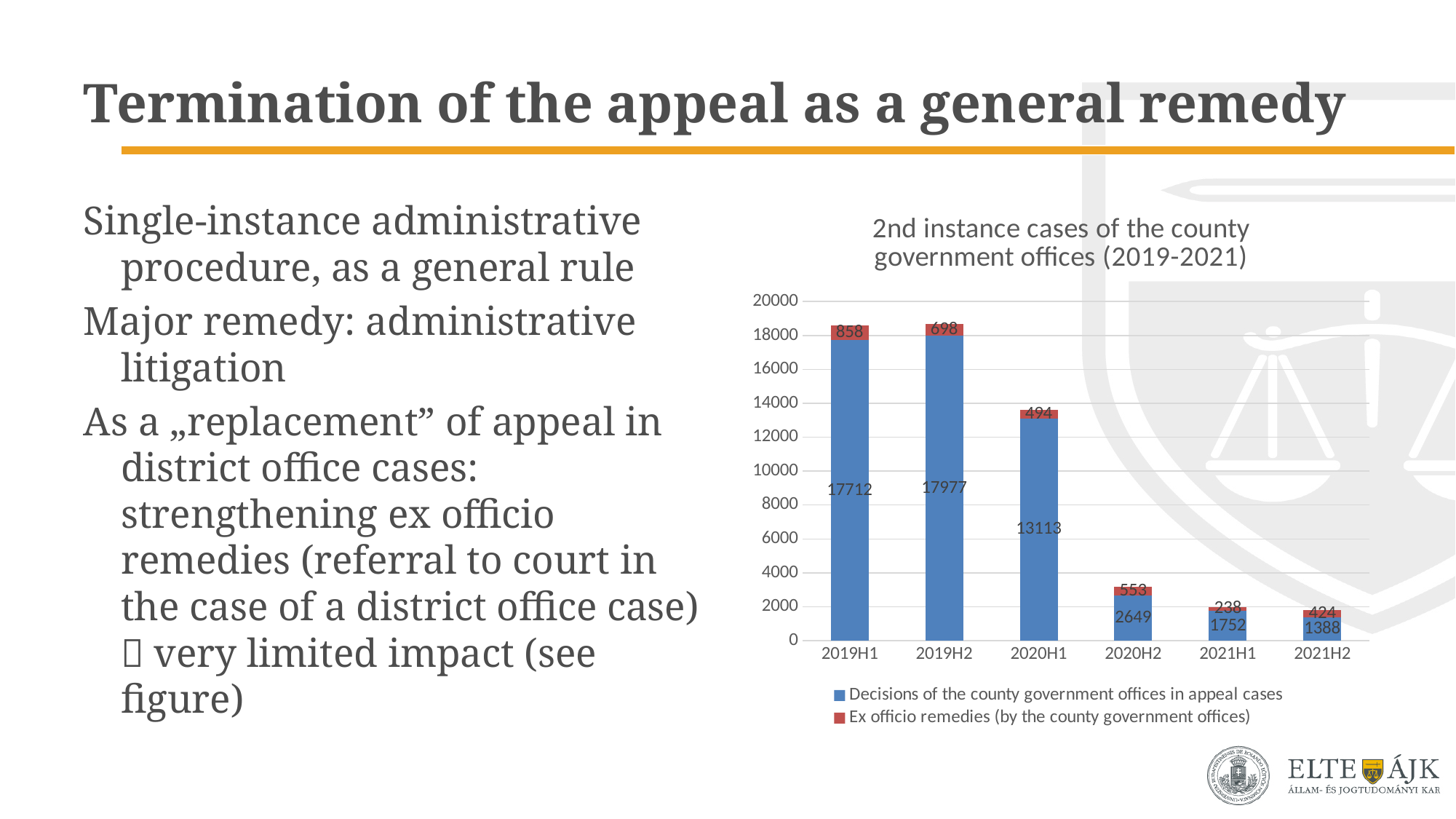
What is the value of Decisions of the county government offices in appeal cases for 2019H2? 17977 What is the title of the chart? 2nd instance cases of the county government offices (2019-2021) What is the total of the stacked bar for 2021H1? 1990 In which period is the value of Decisions of the county government offices in appeal cases the lowest? 2021H2 How many periods (categories) are shown on the x axis of the chart? 6 In which period is the value of Ex officio remedies (by the county government offices) the highest? 2019H1 Which is larger: Ex officio remedies in 2020H2 or in 2021H2? 2020H2 How many series does the chart legend list? 2 What is the difference between the Decisions of the county government offices in appeal cases in 2019H2 and 2020H1? 4864 What type of chart is shown on the slide? Stacked bar chart What is the value of Ex officio remedies (by the county government offices) for 2020H2? 553 Do the Decisions of the county government offices in appeal cases generally rise or fall from 2019H2 to 2021H2? Fall